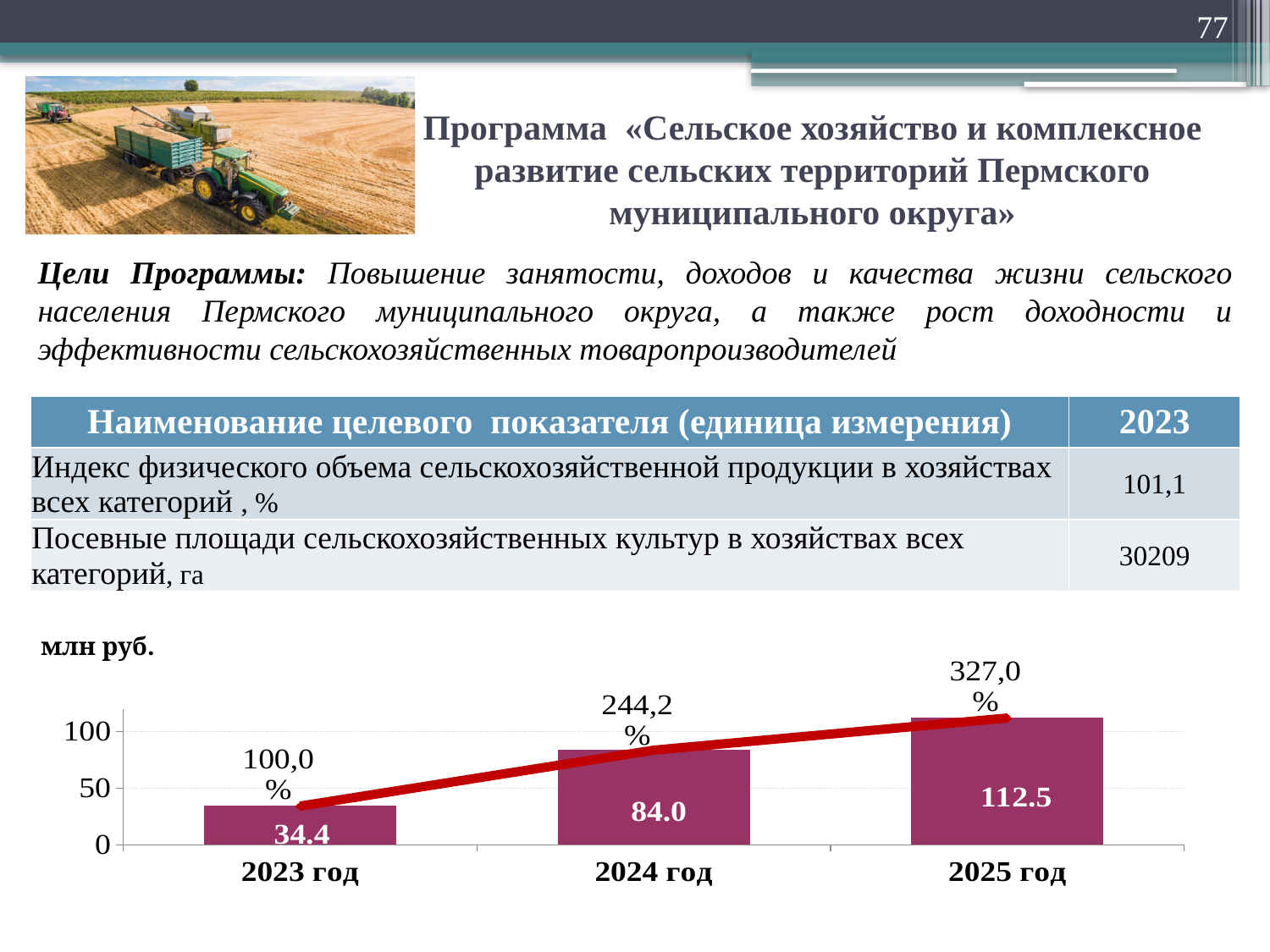
Do the bar values rise or fall from 2023 год to 2025 год? rise What kind of chart is shown at the bottom of the slide? combination bar and line chart Is the value for 2025 год greater or less than 100? greater How many years are shown on the x axis of the chart? 3 Which is larger, the value for 2024 год or the value for 2023 год? 2024 год Which year has the highest bar in the chart? 2025 год What is the difference between the values for 2024 год and 2023 год? 49.6 What is the value for 2024 год in the bar chart? 84.0 What is the value for 2025 год in the bar chart? 112.5 Which year has the lowest bar in the chart? 2023 год What is the value for 2023 год in the bar chart? 34.4 What is the difference between the values for 2025 год and 2024 год? 28.5